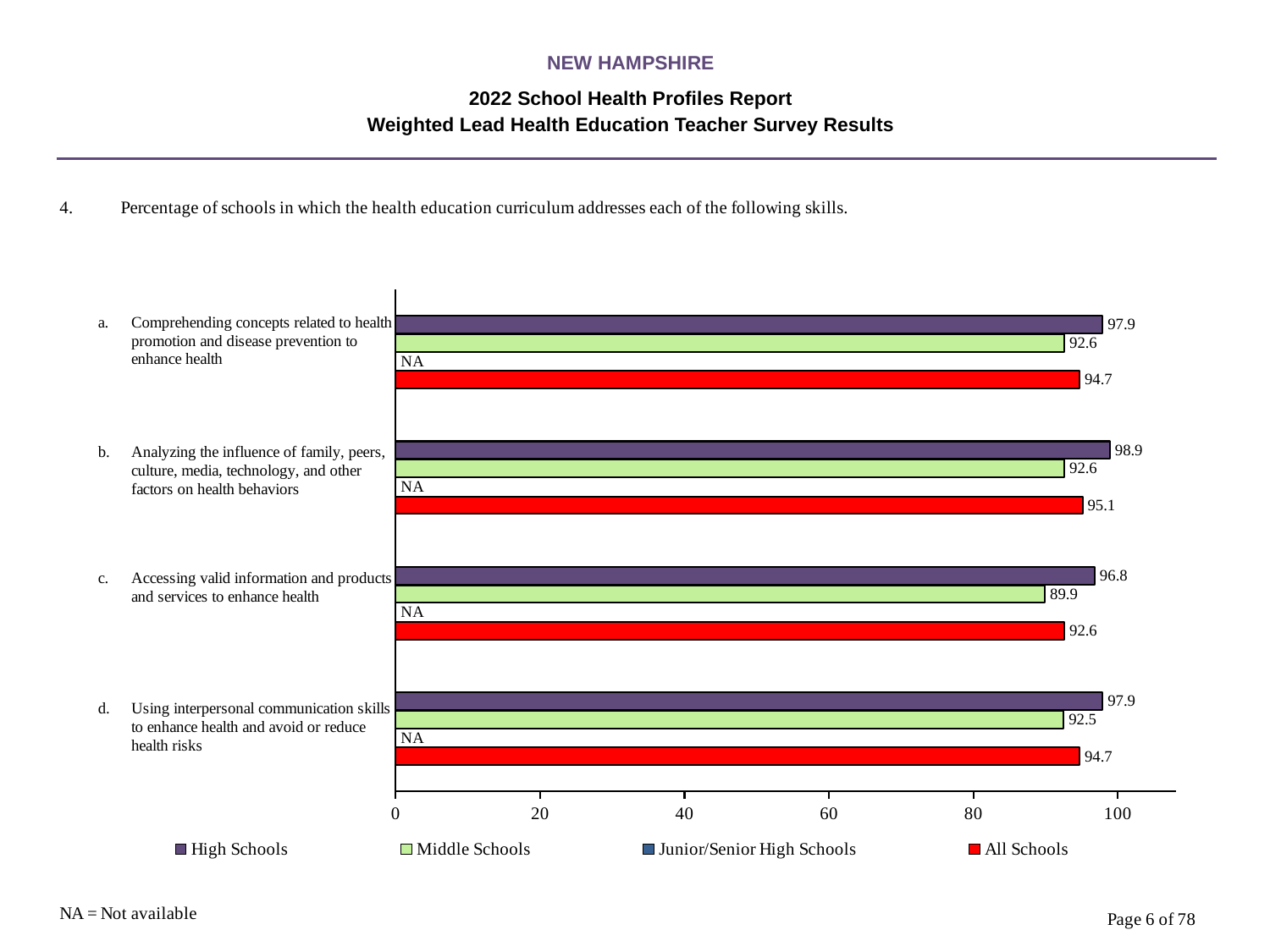
What kind of chart is shown on the slide? Bar chart How many skills (categories) are shown in the chart? 4 What is the value for All Schools for 'Using interpersonal communication skills to enhance health and avoid or reduce health risks'? 94.7 What value is shown for Junior/Senior High Schools for each skill? NA What is the value for Middle Schools for 'Accessing valid information and products and services to enhance health'? 89.9 Which skill has the highest value for High Schools? Analyzing the influence of family, peers, culture, media, technology, and other factors on health behaviors Which skill has the lowest value for Middle Schools? Accessing valid information and products and services to enhance health Which is larger for 'Comprehending concepts related to health promotion and disease prevention to enhance health': the High Schools value or the All Schools value? High Schools How many series does the legend list? 4 What is the difference between the High Schools and Middle Schools values for 'Accessing valid information and products and services to enhance health'? 6.9 What is the value for High Schools for 'Analyzing the influence of family, peers, culture, media, technology, and other factors on health behaviors'? 98.9 What colour are the All Schools bars? Red